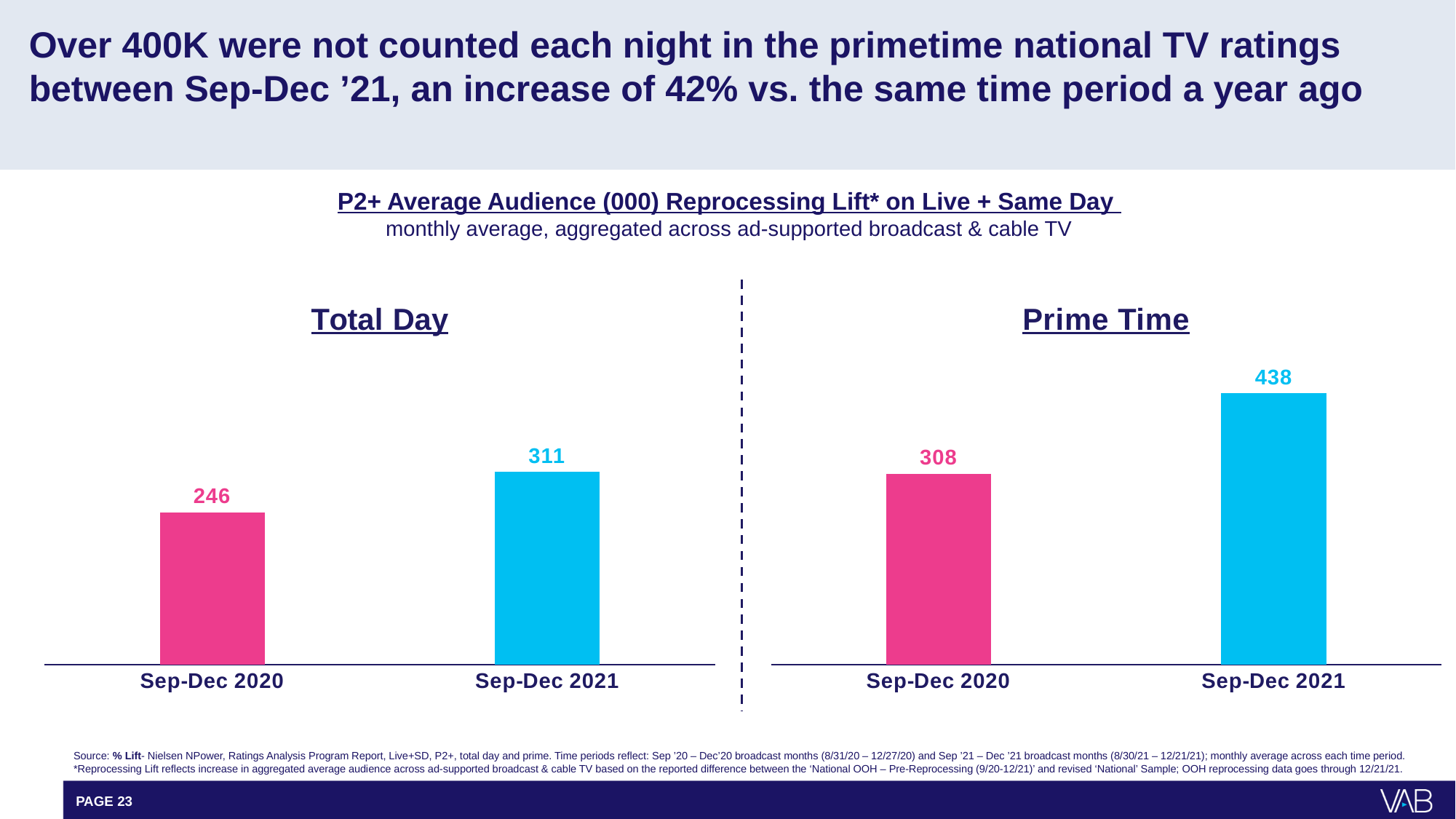
In the Prime Time chart, what is the value for Sep-Dec 2021? 438 In the Total Day chart, which period has the lowest value? Sep-Dec 2020 In the Total Day chart, what is the difference between the Sep-Dec 2021 and Sep-Dec 2020 values? 65 In the Prime Time chart, what is the difference between the Sep-Dec 2021 and Sep-Dec 2020 values? 130 In the Prime Time chart, do the values rise or fall from Sep-Dec 2020 to Sep-Dec 2021? Rise What type of chart is the Prime Time chart? Bar chart Is the Sep-Dec 2021 value larger in the Total Day chart or the Prime Time chart? Prime Time In the Prime Time chart, which period has the highest value? Sep-Dec 2021 How many bars are shown in the Total Day chart? 2 In the Prime Time chart, what is the value for Sep-Dec 2020? 308 In the Total Day chart, what is the value for Sep-Dec 2020? 246 In the Total Day chart, what is the value for Sep-Dec 2021? 311